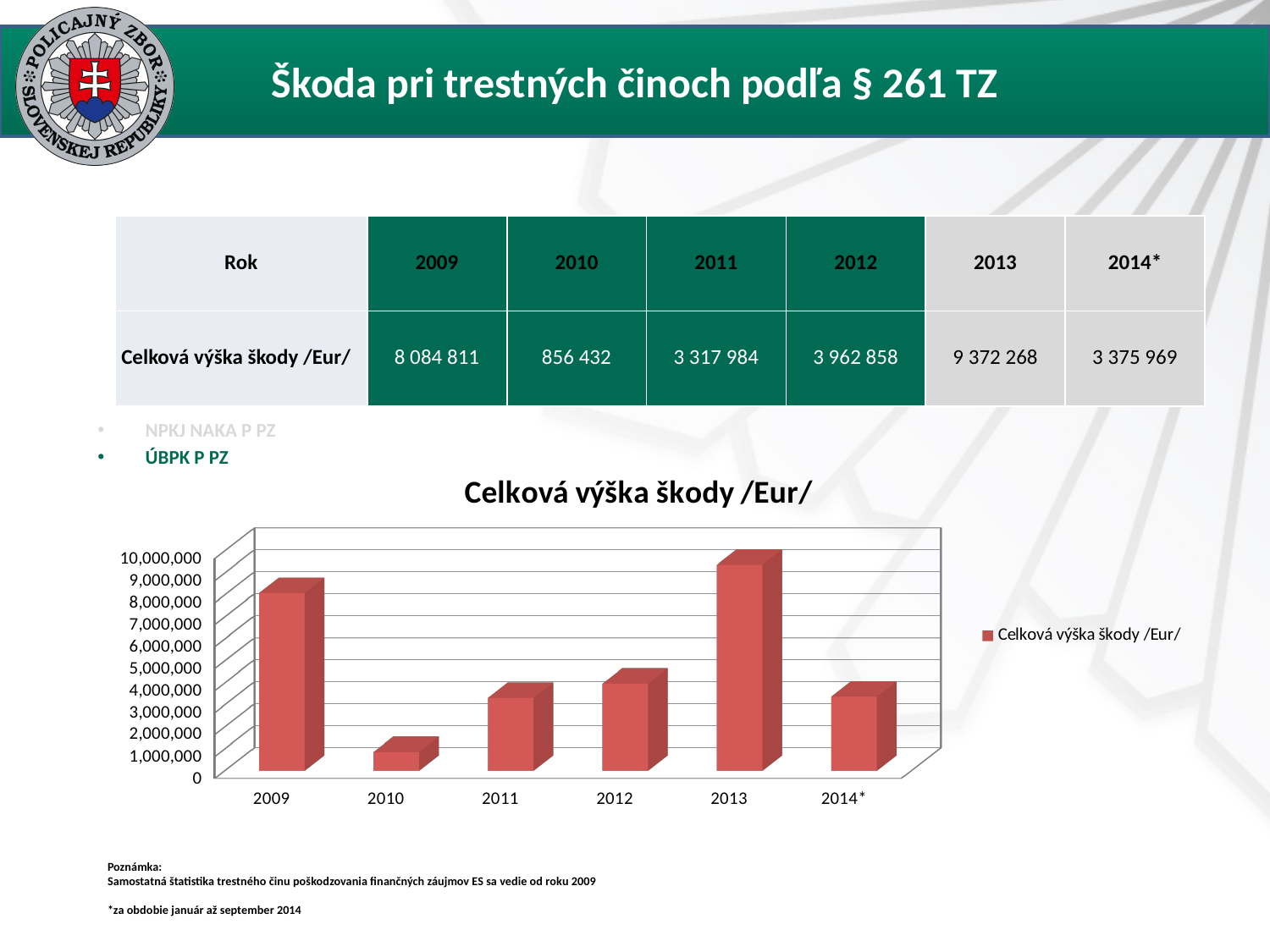
Does the value fall or rise from 2009 to 2010 in the chart? fall Is the value for 2013 in the chart greater or less than 9,000,000? greater According to the table, what is the Celková výška škody /Eur/ for 2011? 3 317 984 What type of chart is shown on the slide? bar chart Is the value for 2014* in the chart greater or less than 4,000,000? less Which is larger in the chart, the value for 2009 or the value for 2013? 2013 Which year has the lowest Celková výška škody /Eur/ in the chart? 2010 Which year has the highest Celková výška škody /Eur/ in the chart? 2013 Is the value for 2010 in the chart greater or less than 1,000,000? less What is the title of the chart? Celková výška škody /Eur/ How many series does the chart legend list? 1 How many years (categories) are shown on the x axis of the chart? 6